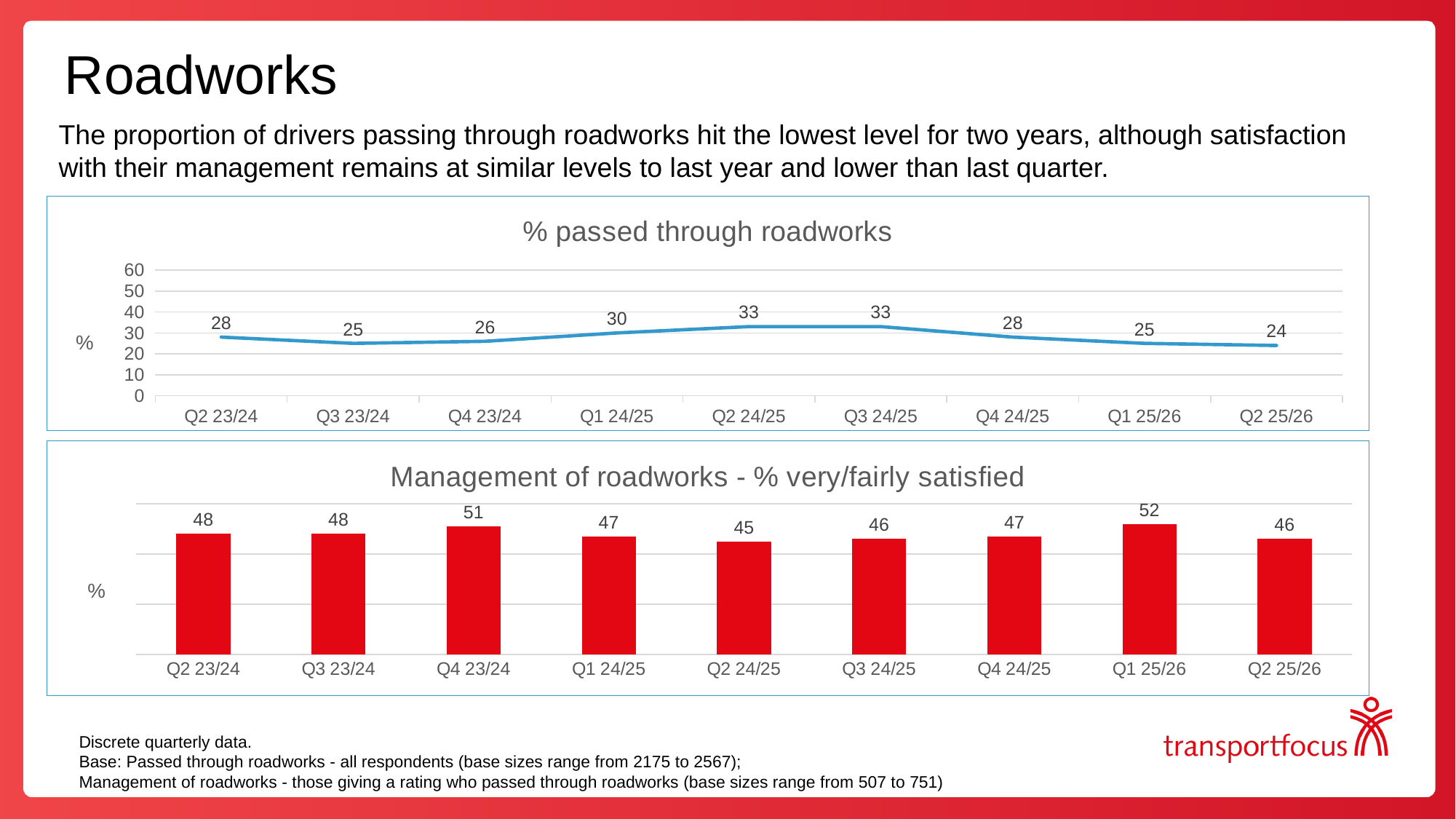
In the '% passed through roadworks' chart, what is the difference between Q3 24/25 and Q2 25/26? 9 In the '% passed through roadworks' chart, how many quarters are plotted? 9 In the 'Management of roadworks - % very/fairly satisfied' chart, what is the value for Q1 25/26? 52 In the 'Management of roadworks - % very/fairly satisfied' chart, which quarter has the lowest value? Q2 24/25 In the '% passed through roadworks' chart, which quarter has the lowest value? Q2 25/26 In the 'Management of roadworks - % very/fairly satisfied' chart, which quarter has the highest value? Q1 25/26 In the 'Management of roadworks - % very/fairly satisfied' chart, what is the difference between Q1 25/26 and Q2 25/26? 6 What kind of chart is the '% passed through roadworks' chart? Line chart In the '% passed through roadworks' chart, what is the value for Q1 24/25? 30 In the 'Management of roadworks - % very/fairly satisfied' chart, which is larger, Q4 23/24 or Q2 24/25? Q4 23/24 In the '% passed through roadworks' chart, what is the value for Q2 25/26? 24 What kind of chart is the 'Management of roadworks - % very/fairly satisfied' chart? Bar chart